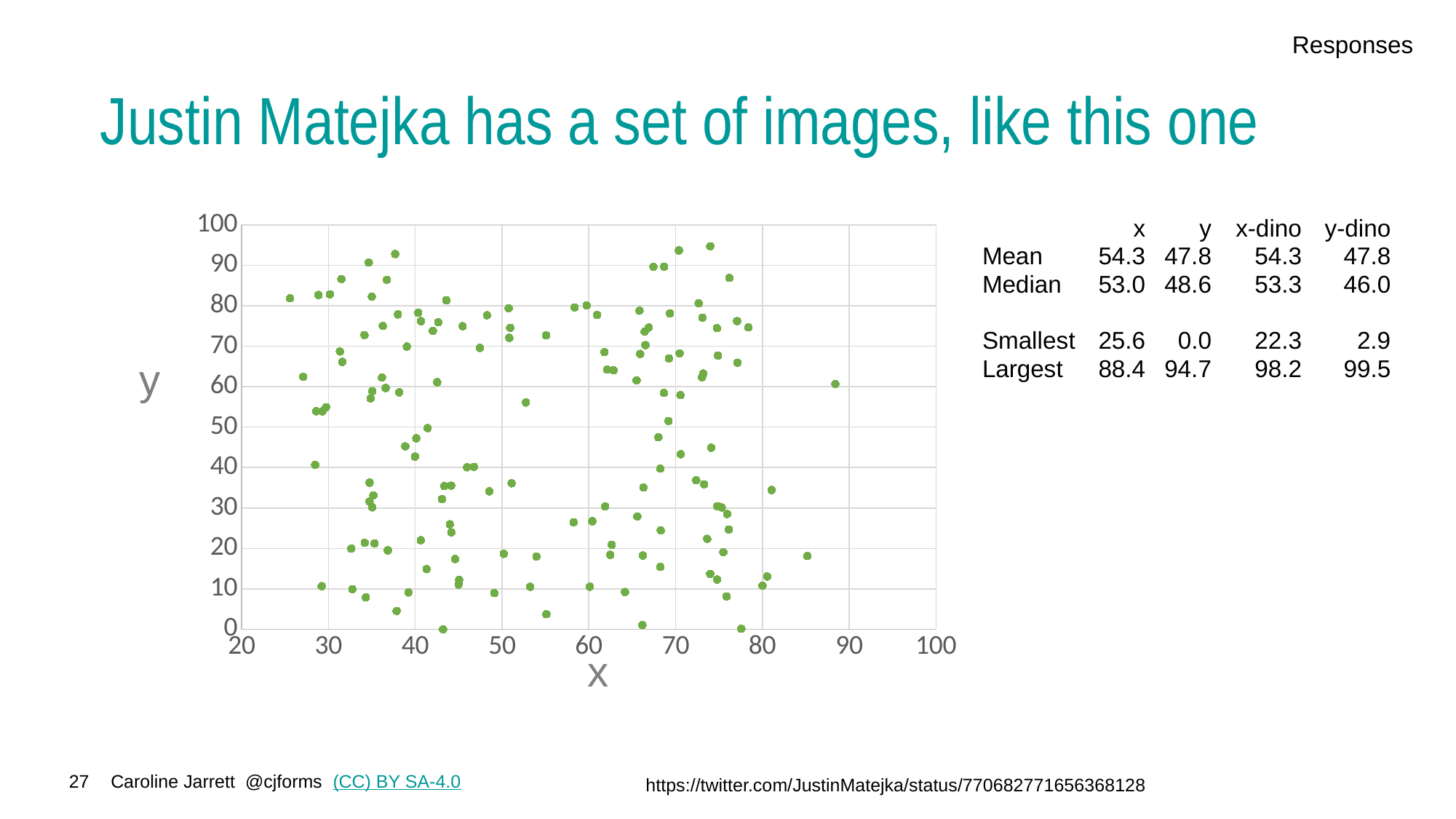
According to the table beside the chart, what is the smallest value of y? 0.0 According to the table beside the chart, what is the smallest value of x? 25.6 According to the table beside the chart, what is the median of y-dino? 46.0 According to the table, what is the difference between the median of x and the median of y? 4.4 According to the table beside the chart, what is the largest value of y? 94.7 Is the largest y value shown in the table greater or less than 90? greater What kind of chart is shown on the slide? scatter plot According to the table beside the chart, what is the mean of x? 54.3 What colour are the plotted points in the chart? green According to the table, what is the difference between the largest x-dino value and the largest x value? 9.8 What is the label on the horizontal axis of the chart? x According to the table, which is larger: the mean of x or the mean of y? mean of x